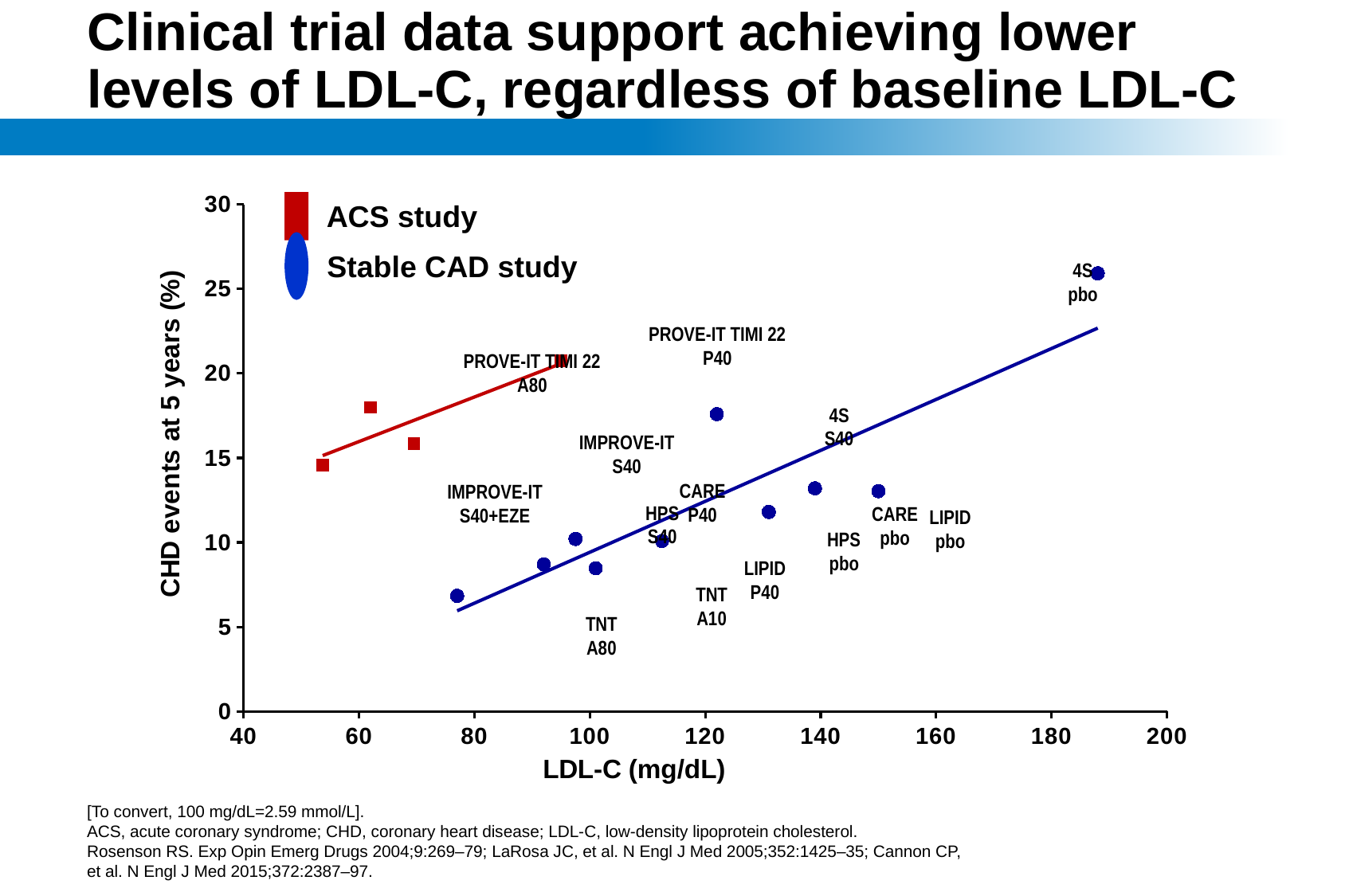
Which study type is represented by the red squares in the legend? ACS study What kind of chart is shown on the slide? scatter chart Which has a higher CHD events value, the 4S pbo point or the IMPROVE-IT S40+EZE point? 4S pbo How many Stable CAD study (blue) points are plotted? 10 Is the CHD events value for the IMPROVE-IT S40+EZE point greater or less than 10%? less Is the CHD events value for the 4S pbo point greater or less than 20%? greater Along the Stable CAD study trend line, do CHD events rise or fall as LDL-C increases? rise Is the LDL-C value for the 4S pbo point greater or less than 180 mg/dL? greater Which labelled point has the highest CHD events at 5 years? 4S pbo What is the label of the x axis? LDL-C (mg/dL) How many series does the legend list? 2